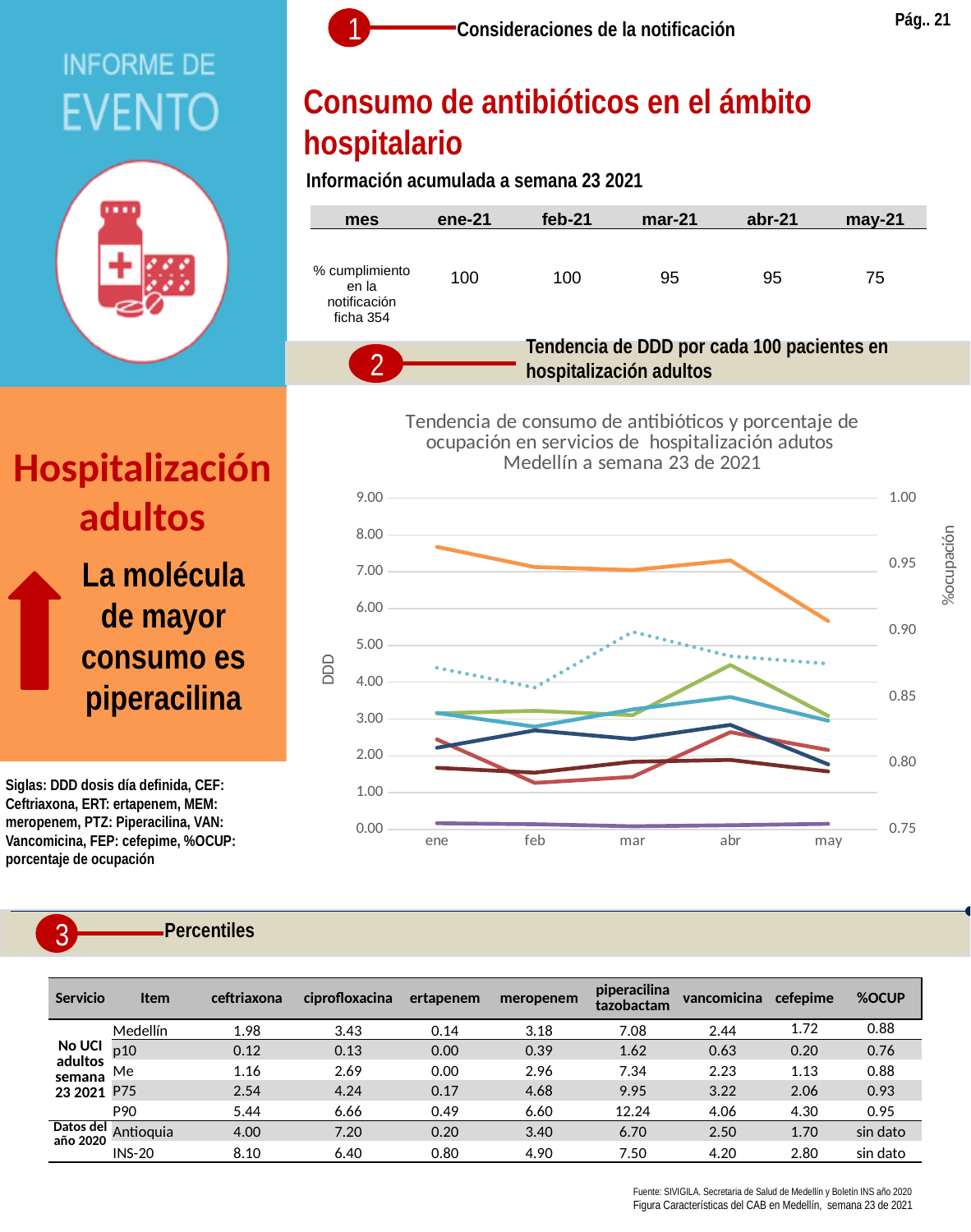
Is the value of the green line in abr greater or less than 4.00 on the DDD axis? greater How many months are plotted along the x axis of the chart? 5 What kind of chart is shown on the slide? line chart What is the label of the left vertical axis of the chart? DDD Is the value of the orange line in may greater or less than 6.00 on the DDD axis? less What is the label of the right vertical axis of the chart? %ocupación Is the value of the purple line in mar greater or less than 1.00 on the DDD axis? less In which month does the green line reach its highest value? abr In which month does the orange line reach its highest value? ene Does the orange line end higher or lower in may than it starts in ene? lower In which month does the orange line reach its lowest value? may